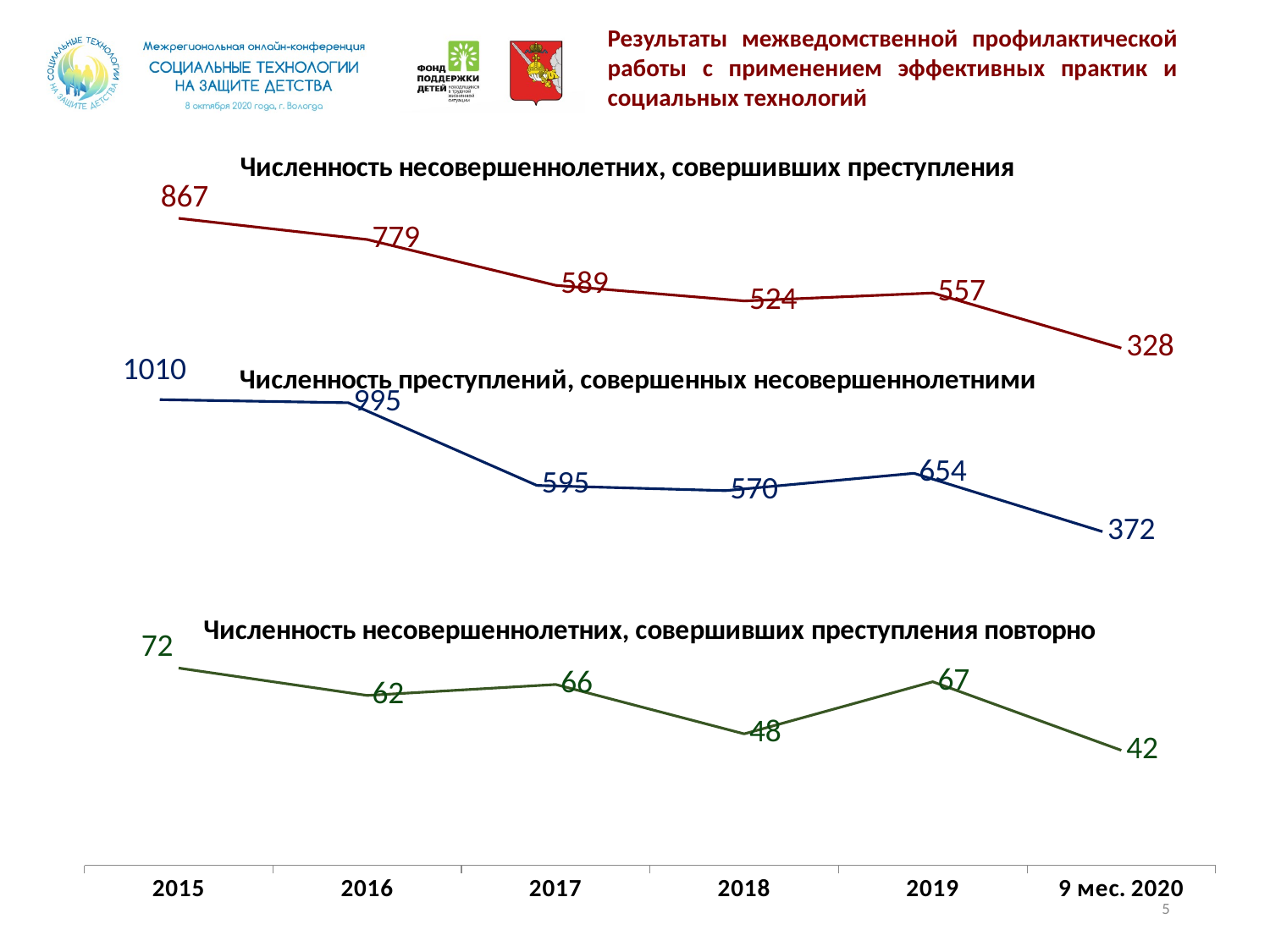
How many time periods are shown on the x axis? 6 What is the difference between the 2019 and "9 мес. 2020" values in the series "Численность преступлений, совершенных несовершеннолетними"? 282 In the series "Численность несовершеннолетних, совершивших преступления повторно", which period has the highest value? 2015 In the series "Численность несовершеннолетних, совершивших преступления", which period has the lowest value? 9 мес. 2020 What is the value for "9 мес. 2020" in the series "Численность преступлений, совершенных несовершеннолетними"? 372 What kind of chart is shown on the slide? Line chart What is the value for 2015 in the series "Численность несовершеннолетних, совершивших преступления"? 867 What is the difference between the 2015 and 2016 values in the series "Численность несовершеннолетних, совершивших преступления"? 88 What is the value for 2018 in the series "Численность несовершеннолетних, совершивших преступления повторно"? 48 In the series "Численность несовершеннолетних, совершивших преступления повторно", which is larger: the value for 2017 or the value for 2019? 2019 Does the series "Численность преступлений, совершенных несовершеннолетними" rise or fall from 2015 to 2017? Fall What is the value for 2017 in the series "Численность преступлений, совершенных несовершеннолетними"? 595